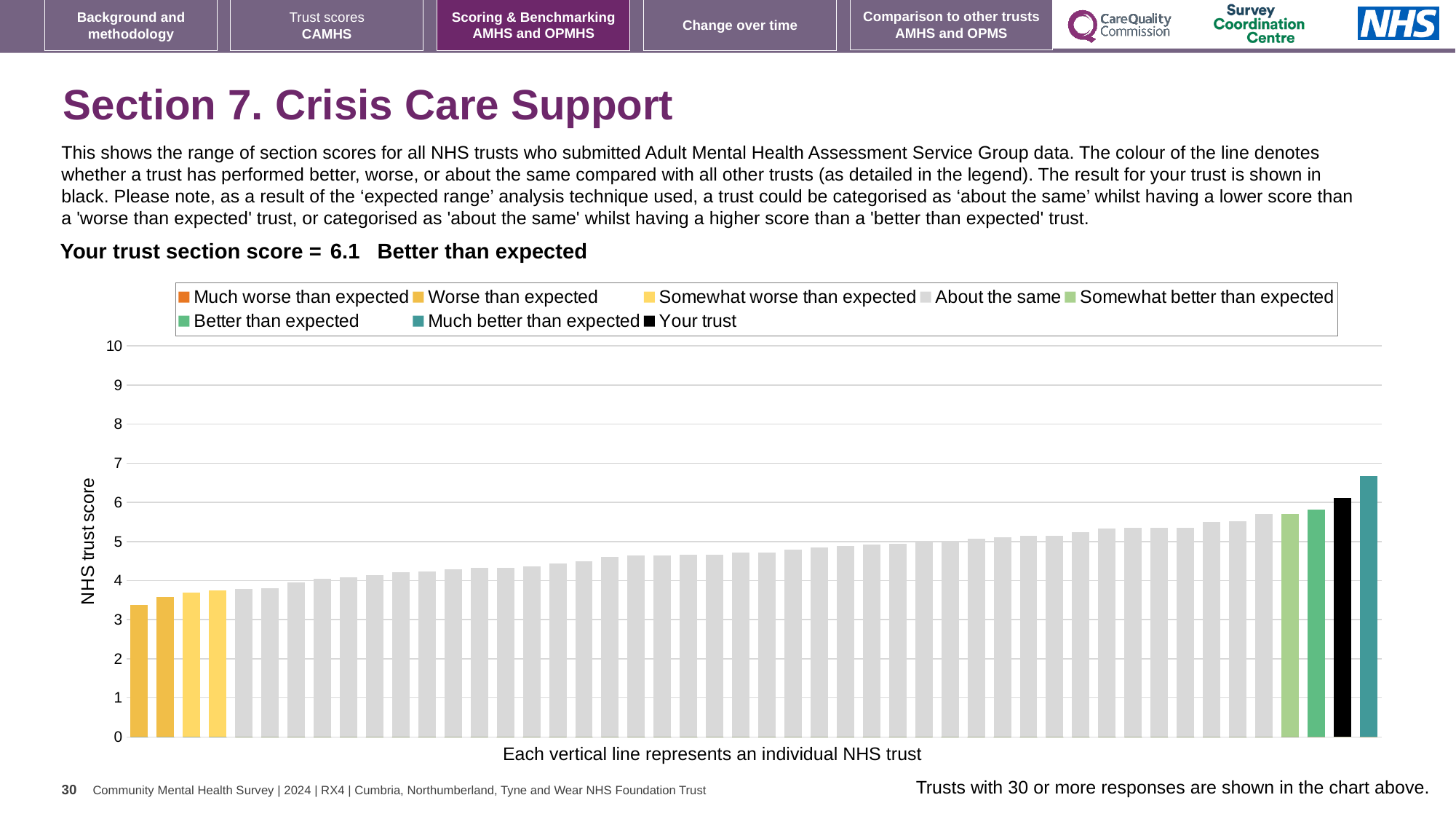
Do the bar values rise or fall from left to right across the chart? rise Which legend category does the tallest bar in the chart belong to? Much better than expected How many entries does the chart legend list? 8 According to the slide, how is your trust's section score categorised? Better than expected Is the value of the black 'Your trust' bar greater or less than 5? greater What kind of chart is shown on the slide? bar chart Is the value of the tallest bar (Much better than expected) greater or less than 7? less How many black 'Your trust' bars are shown in the chart? 1 Is the 'Much better than expected' bar higher or lower than the 'Your trust' bar? higher What is the label on the vertical axis of the chart? NHS trust score What is the section score for your trust shown on the slide? 6.1 Is the value of the shortest bar in the chart greater or less than 4? less